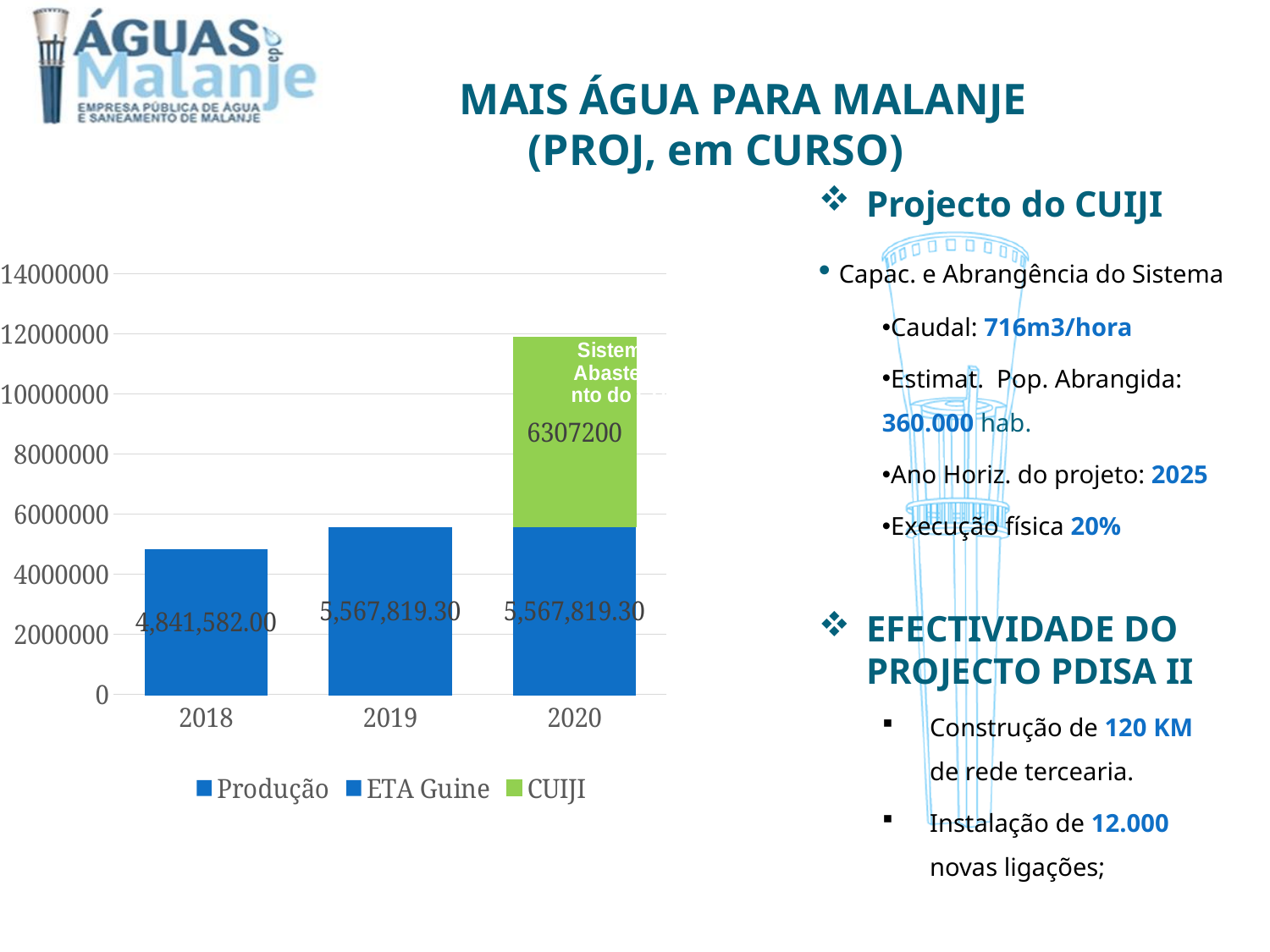
Which year has the highest total bar? 2020 What value is labelled on the blue bar for 2019? 5,567,819.30 What is the total of the stacked bar for 2020? 11,875,019.30 How many series does the chart legend list? 3 Which series is shown in green in the legend? CUIJI What type of chart is shown on the slide? bar chart How many years are shown on the x axis of the chart? 3 What value is labelled on the blue bar for 2018? 4,841,582.00 Which year has the lowest total bar? 2018 What is the difference between the blue bar values for 2019 and 2018? 726,237.30 What value is labelled on the green CUIJI segment for 2020? 6307200 Is the total bar for 2020 greater or less than 10000000? greater